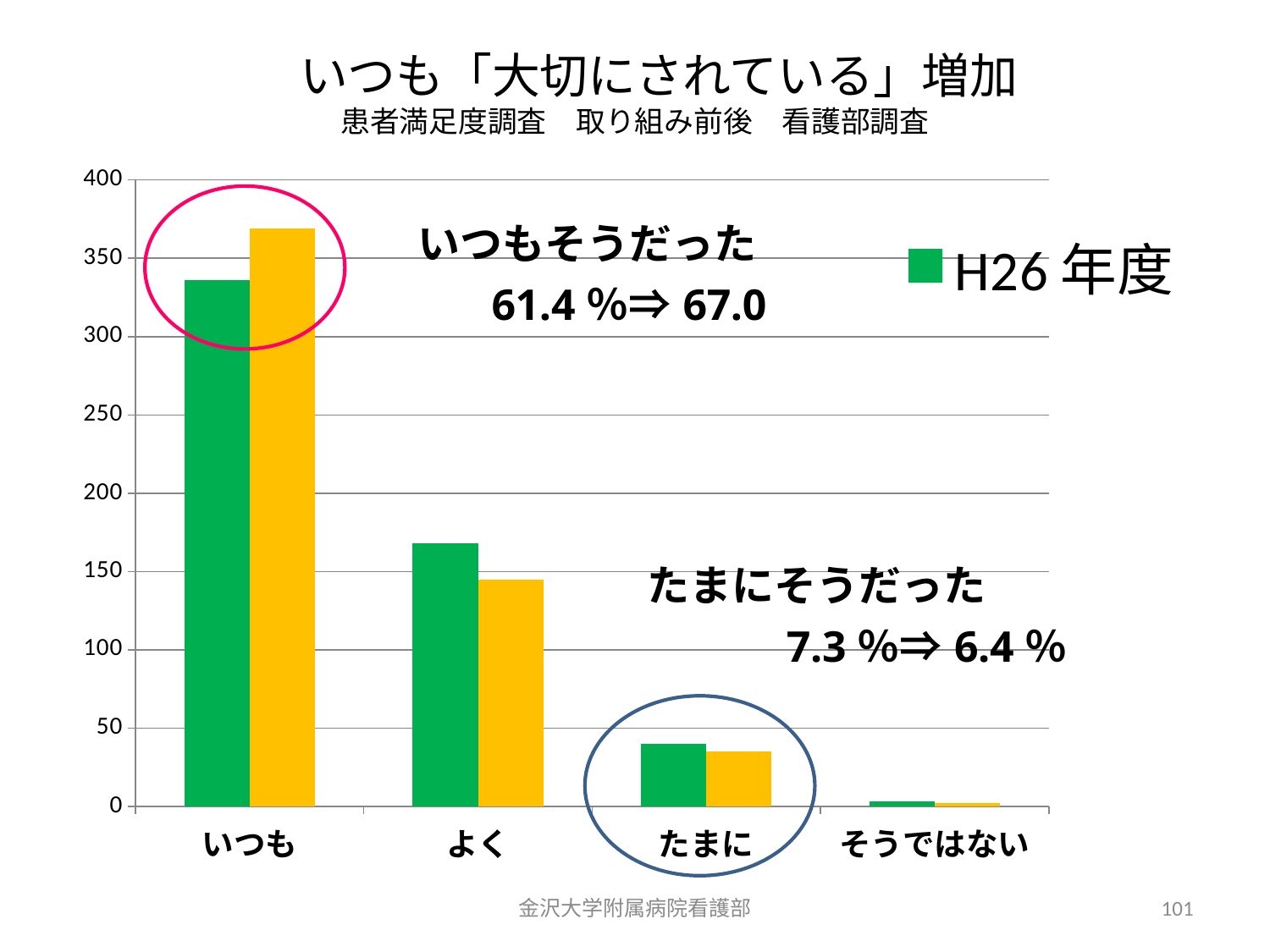
Is the yellow bar for よく greater or less than 200? less For the category よく, which bar is taller, the green one or the yellow one? the green one Is the yellow bar for いつも greater or less than 350? greater Is the green bar for いつも greater or less than 300? greater For the category いつも, which bar is taller, the green one or the yellow one? the yellow one What kind of chart is shown on the slide? bar chart Which category has the tallest bars in the chart? いつも Do the bar heights rise or fall moving from いつも to そうではない along the x axis? fall Which category has the shortest bars in the chart? そうではない How many categories are shown on the x axis of the chart? 4